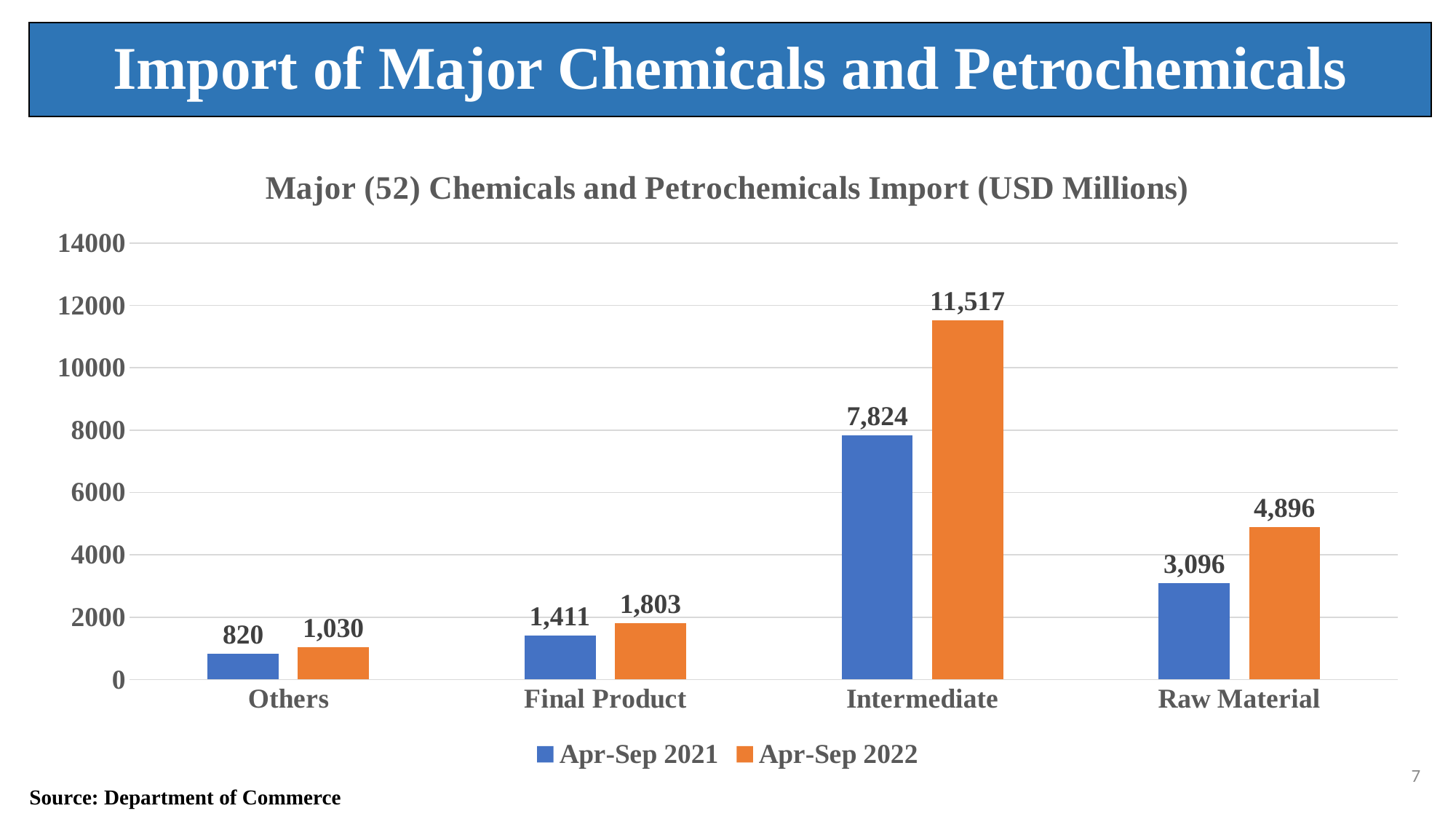
What kind of chart is shown on the slide? Bar chart What is the difference between the Apr-Sep 2022 and Apr-Sep 2021 import values for Final Product? 392 What is the difference between the Apr-Sep 2022 and Apr-Sep 2021 import values for Intermediate? 3,693 What is the import value for Intermediate in Apr-Sep 2022? 11,517 How many series does the legend list? 2 How many categories are shown on the x axis? 4 What is the import value for Raw Material in Apr-Sep 2021? 3,096 Which is larger: the Apr-Sep 2021 value for Raw Material or the Apr-Sep 2022 value for Final Product? Apr-Sep 2021 value for Raw Material Which category has the lowest import value in Apr-Sep 2021? Others Is the Apr-Sep 2022 value for Raw Material greater or less than 4000? greater What is the import value for Others in Apr-Sep 2022? 1,030 Which category has the highest import value in Apr-Sep 2022? Intermediate